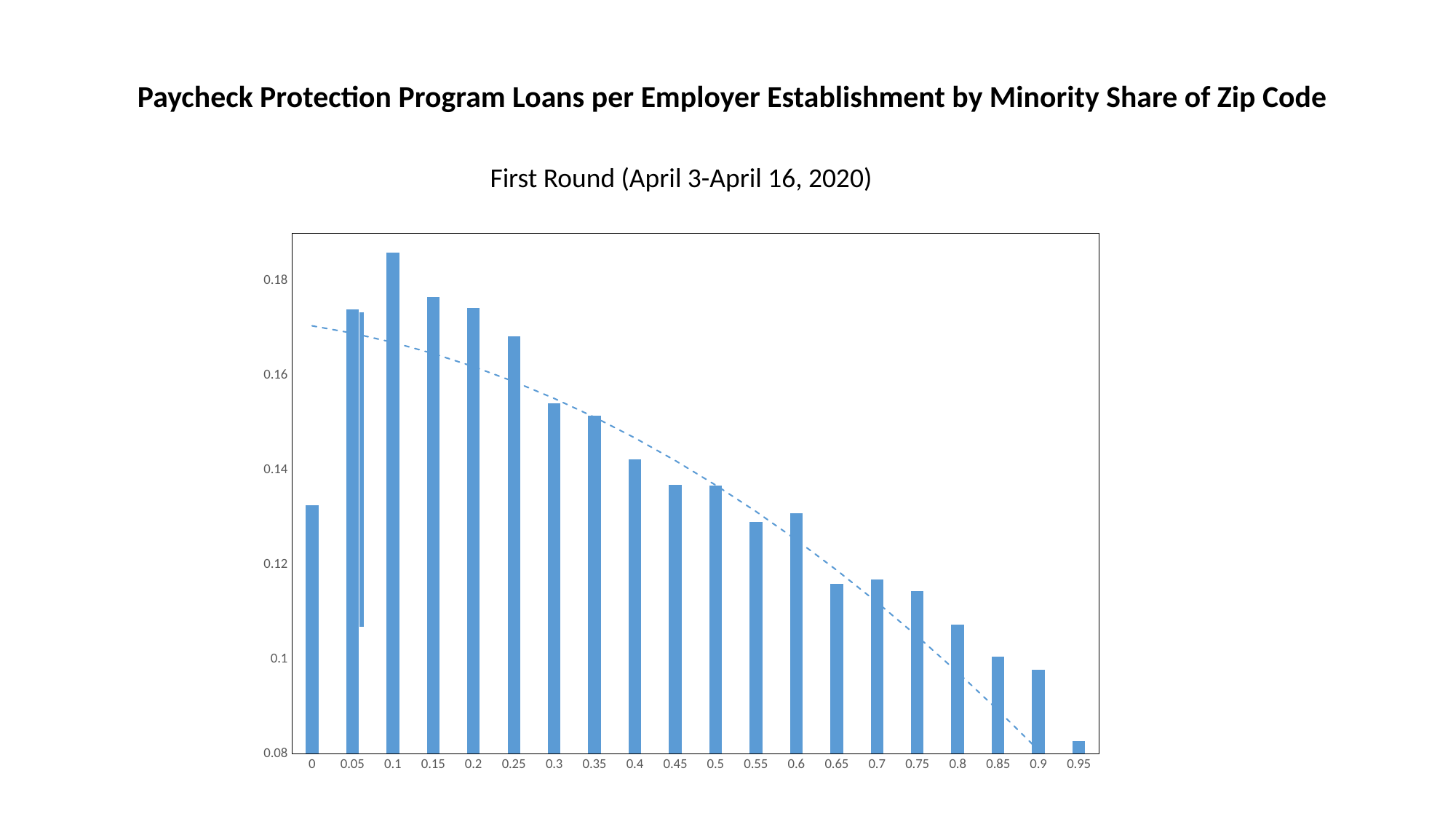
How many minority share categories are shown on the x axis? 20 What time period does the chart's subtitle say the data covers? First Round (April 3-April 16, 2020) What kind of chart is shown on the slide? bar chart Which has the larger value, the 0.75 category or the 0.8 category? 0.75 Which has the larger value, the 0.1 category or the 0.2 category? 0.1 Is the value for the 0.65 category greater or less than 0.12? less Do the bar values generally rise or fall as the minority share increases along the x axis? fall Is the value for the 0.25 category greater or less than 0.16? greater Which minority share category has the highest value? 0.1 Is the value for the 0.9 category greater or less than 0.1? less Which minority share category has the lowest value? 0.95